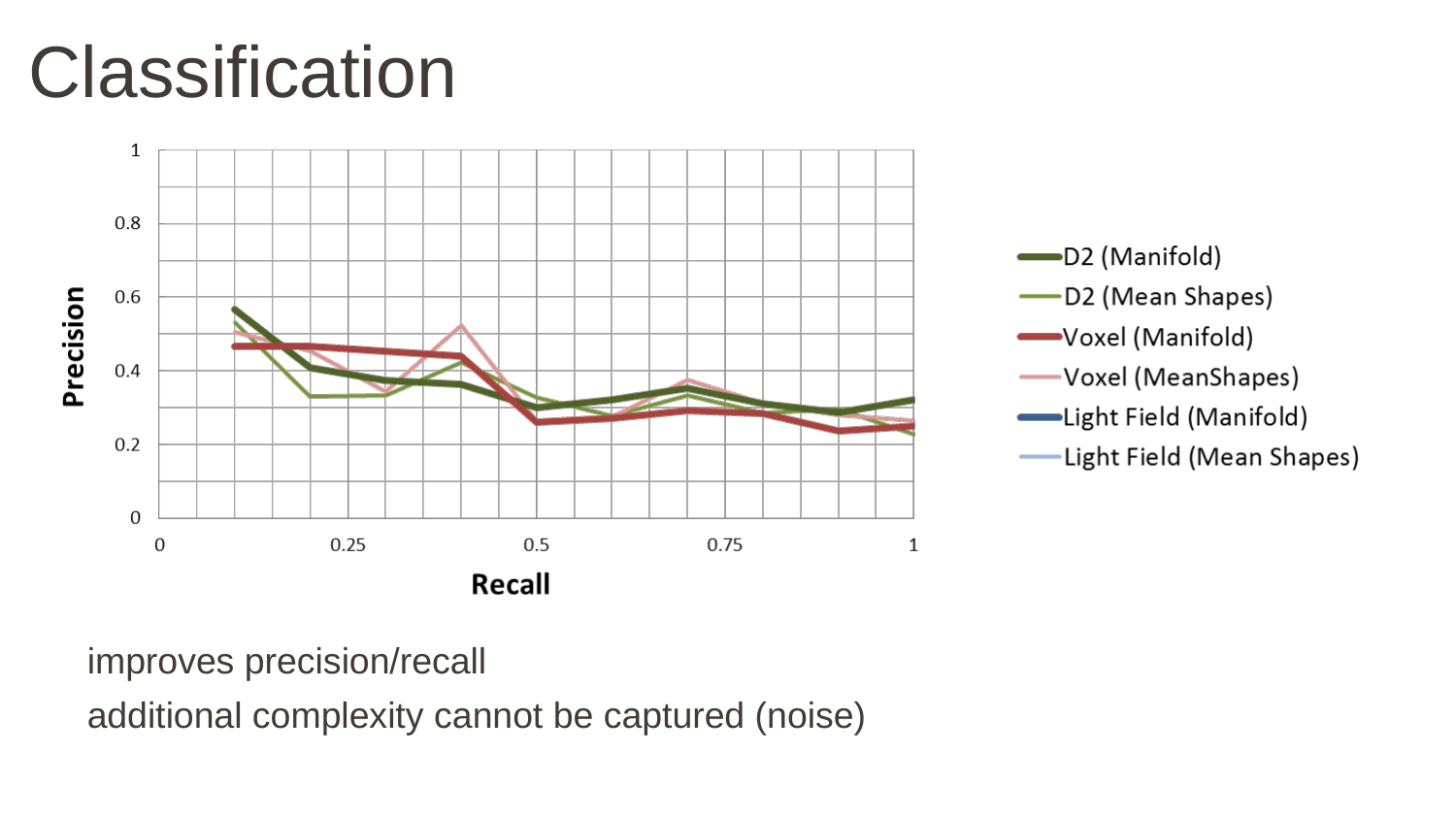
Is the precision of Voxel (MeanShapes) at recall 0.4 greater or less than 0.4? greater What is the label of the y axis? Precision Which series has the highest precision at recall 0.4? Voxel (MeanShapes) How many series does the legend list? 6 Is the precision of D2 (Manifold) at recall 0.1 greater or less than 0.4? greater Which series has the highest precision at recall 0.1? D2 (Manifold) Is the precision of D2 (Mean Shapes) at recall 0.2 greater or less than 0.4? less At recall 0.1, which has higher precision: D2 (Manifold) or Voxel (Manifold)? D2 (Manifold) Does the precision of D2 (Manifold) generally rise or fall as recall increases? fall What kind of chart is shown on the slide? line chart What is the label of the x axis? Recall